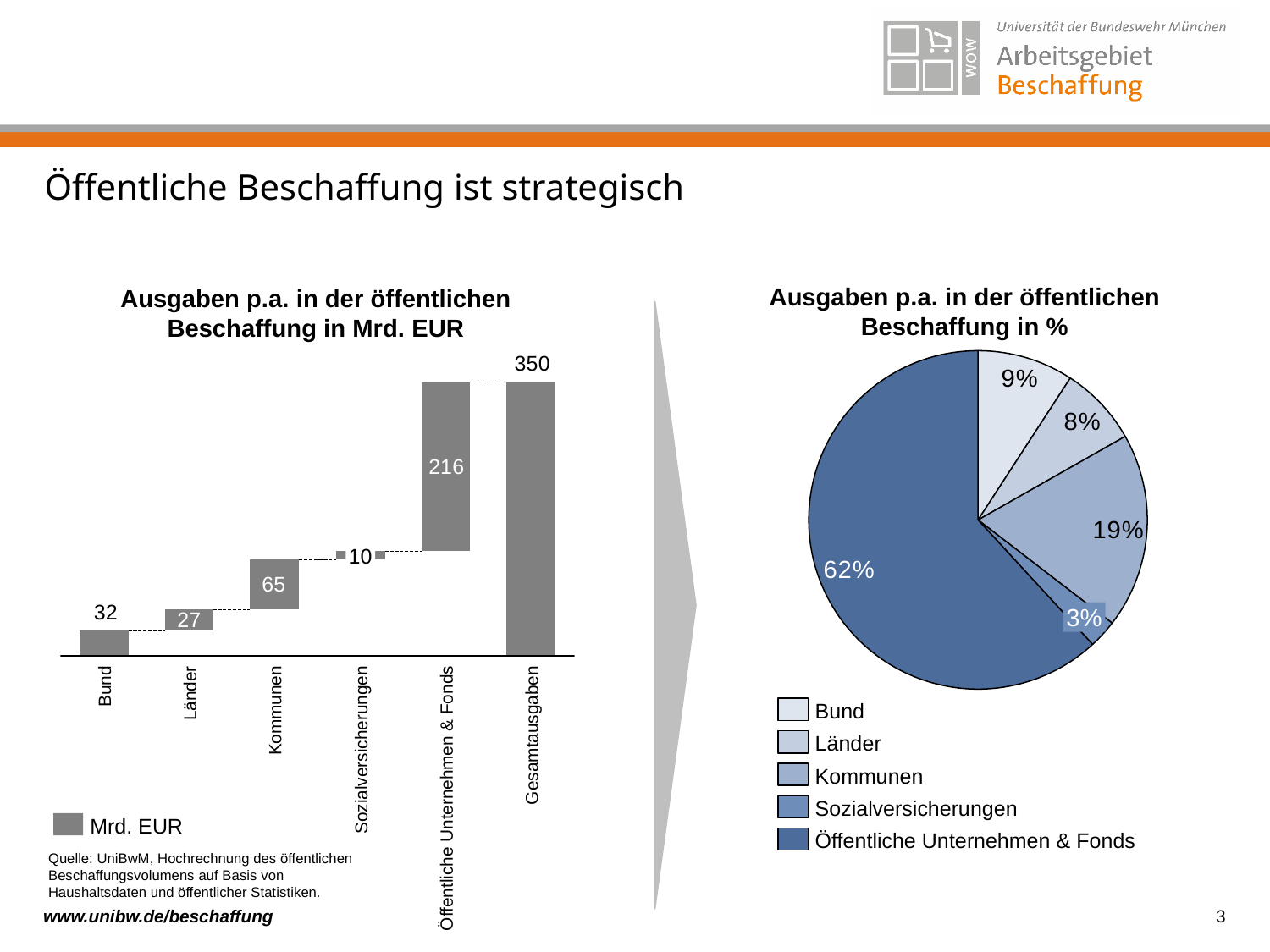
In the pie chart 'Ausgaben p.a. in der öffentlichen Beschaffung in %', what share does Öffentliche Unternehmen & Fonds have? 62% How many entries does the legend of the pie chart 'Ausgaben p.a. in der öffentlichen Beschaffung in %' list? 5 In the chart 'Ausgaben p.a. in der öffentlichen Beschaffung in Mrd. EUR', what is the value for Öffentliche Unternehmen & Fonds? 216 What kind of chart is 'Ausgaben p.a. in der öffentlichen Beschaffung in Mrd. EUR'? Bar chart In the chart 'Ausgaben p.a. in der öffentlichen Beschaffung in Mrd. EUR', which is larger, the value for Kommunen or the value for Bund? Kommunen In the chart 'Ausgaben p.a. in der öffentlichen Beschaffung in Mrd. EUR', which category other than Gesamtausgaben has the lowest value? Sozialversicherungen In the pie chart 'Ausgaben p.a. in der öffentlichen Beschaffung in %', what share does Sozialversicherungen have? 3% In the chart 'Ausgaben p.a. in der öffentlichen Beschaffung in Mrd. EUR', what is the value for Kommunen? 65 In the chart 'Ausgaben p.a. in der öffentlichen Beschaffung in Mrd. EUR', what is the difference between the values for Bund and Länder? 5 In the pie chart 'Ausgaben p.a. in der öffentlichen Beschaffung in %', which category has the largest slice? Öffentliche Unternehmen & Fonds In the chart 'Ausgaben p.a. in der öffentlichen Beschaffung in Mrd. EUR', what is the value for Gesamtausgaben? 350 How many categories are shown on the x axis of the chart 'Ausgaben p.a. in der öffentlichen Beschaffung in Mrd. EUR'? 6